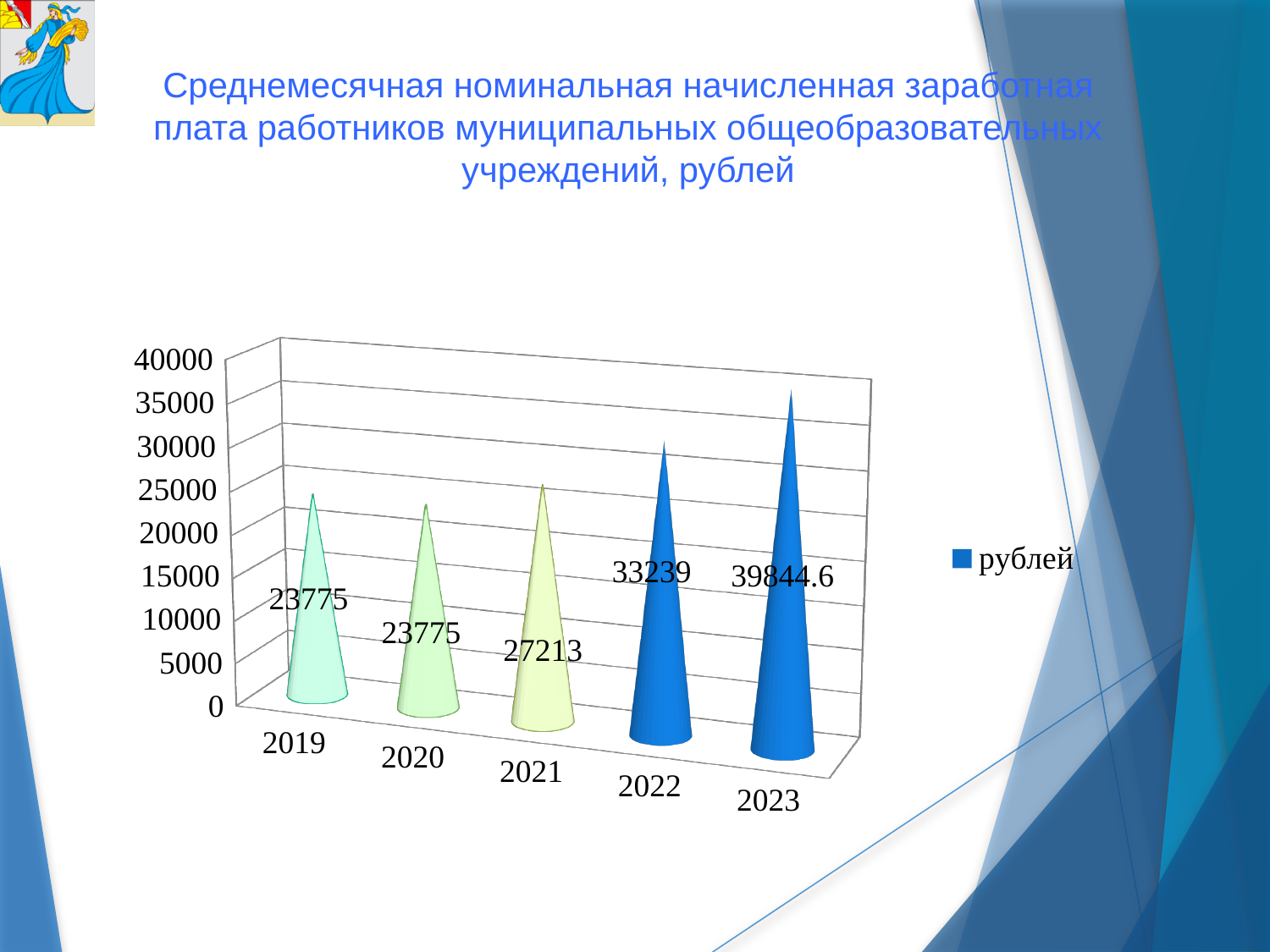
What is the value for 2022? 33239 What is the legend entry of the chart? рублей How many years are shown on the x axis? 5 What is the difference between the values for 2022 and 2021? 6026 Which year has the highest value? 2023 Which is larger, the value for 2020 or the value for 2022? 2022 What is the difference between the values for 2023 and 2022? 6605.6 Is the value for 2019 greater or less than 20000? greater What is the value for 2021? 27213 How many series does the legend list? 1 What is the value for 2023? 39844.6 What kind of chart is shown on the slide? bar chart